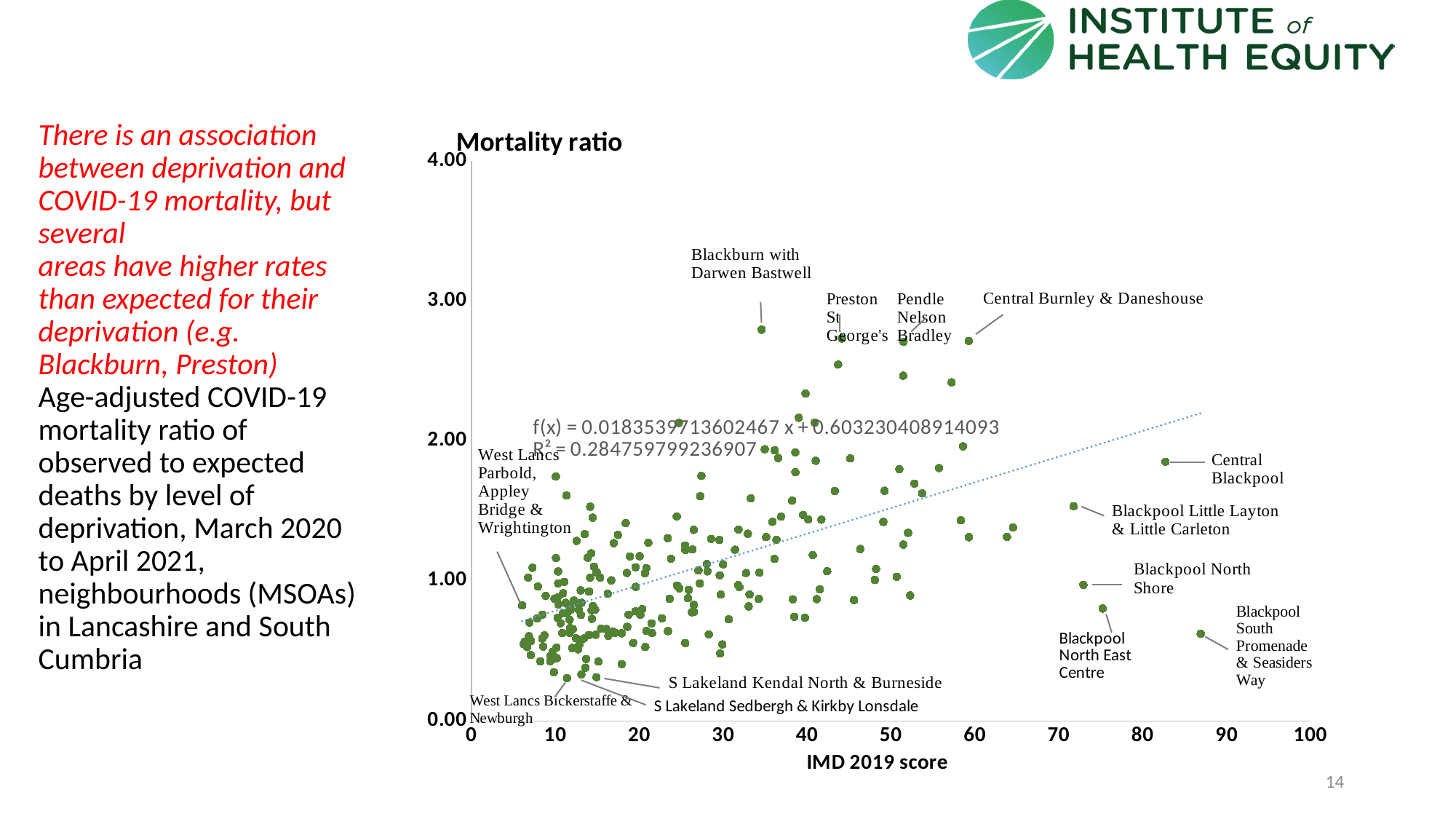
What is the title shown above the chart's y axis? Mortality ratio What kind of chart is shown on the slide? scatter plot Which labelled neighbourhood has the highest IMD 2019 score on the chart? Blackpool South Promenade & Seasiders Way Which has the higher mortality ratio, Central Blackpool or Blackpool North East Centre? Central Blackpool Which has the higher mortality ratio, Blackburn with Darwen Bastwell or Blackpool South Promenade & Seasiders Way? Blackburn with Darwen Bastwell Is the mortality ratio for Central Blackpool greater or less than 2.00? less Does the fitted trend line show the mortality ratio rising or falling as the IMD 2019 score increases? rising Is the mortality ratio for Blackpool Little Layton & Little Carleton greater or less than 1.00? greater Is the mortality ratio for Blackburn with Darwen Bastwell greater or less than 2.00? greater What is the title of the chart's x axis? IMD 2019 score